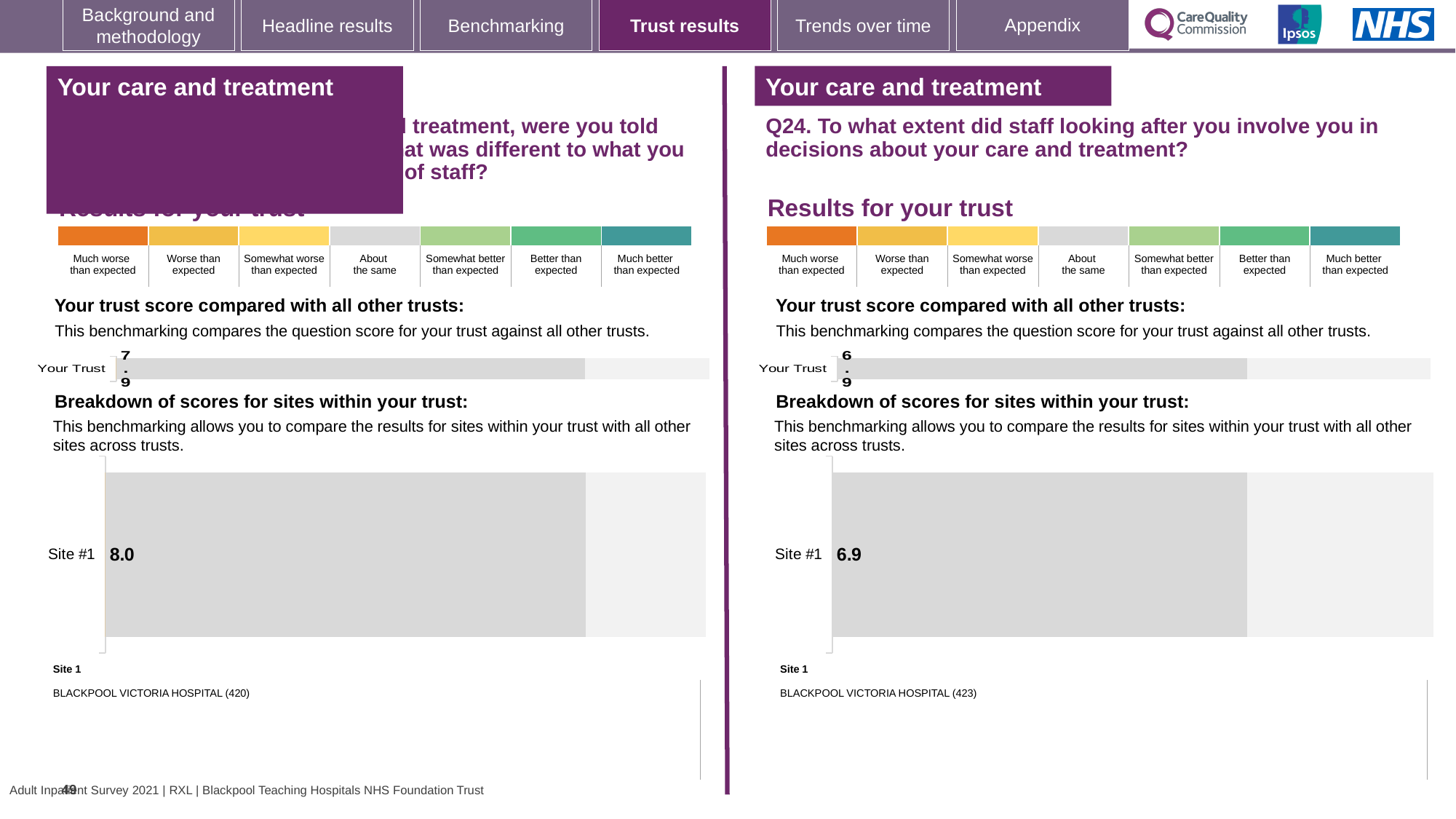
On the right panel (Q24), what is the 'Your Trust' score in the chart comparing the trust score with all other trusts? 6.9 How many categories are shown in the colour scale legend above the 'Your trust score compared with all other trusts' chart on the right panel? 7 On the left panel, what is the 'Your Trust' score in the chart comparing the trust score with all other trusts? 7.9 Which panel shows the higher Site #1 score, the left panel or the right panel (Q24)? Left panel Which hospital is listed as Site 1 on the right panel (Q24)? BLACKPOOL VICTORIA HOSPITAL (423) On the left panel, what is the score shown for Site #1 in the breakdown of scores for sites within your trust? 8.0 On the right panel (Q24), what is the score shown for Site #1 in the breakdown of scores for sites within your trust? 6.9 On the left panel, what is the difference between the Site #1 score and the 'Your Trust' score? 0.1 On the right panel (Q24), is the Site #1 score larger than, smaller than, or equal to the 'Your Trust' score? Equal What kind of chart is used to show the Site #1 score on the left panel? Bar chart How many sites are listed in the breakdown of scores chart on the right panel (Q24)? 1 What is the difference between the Site #1 score on the left panel and the Site #1 score on the right panel (Q24)? 1.1